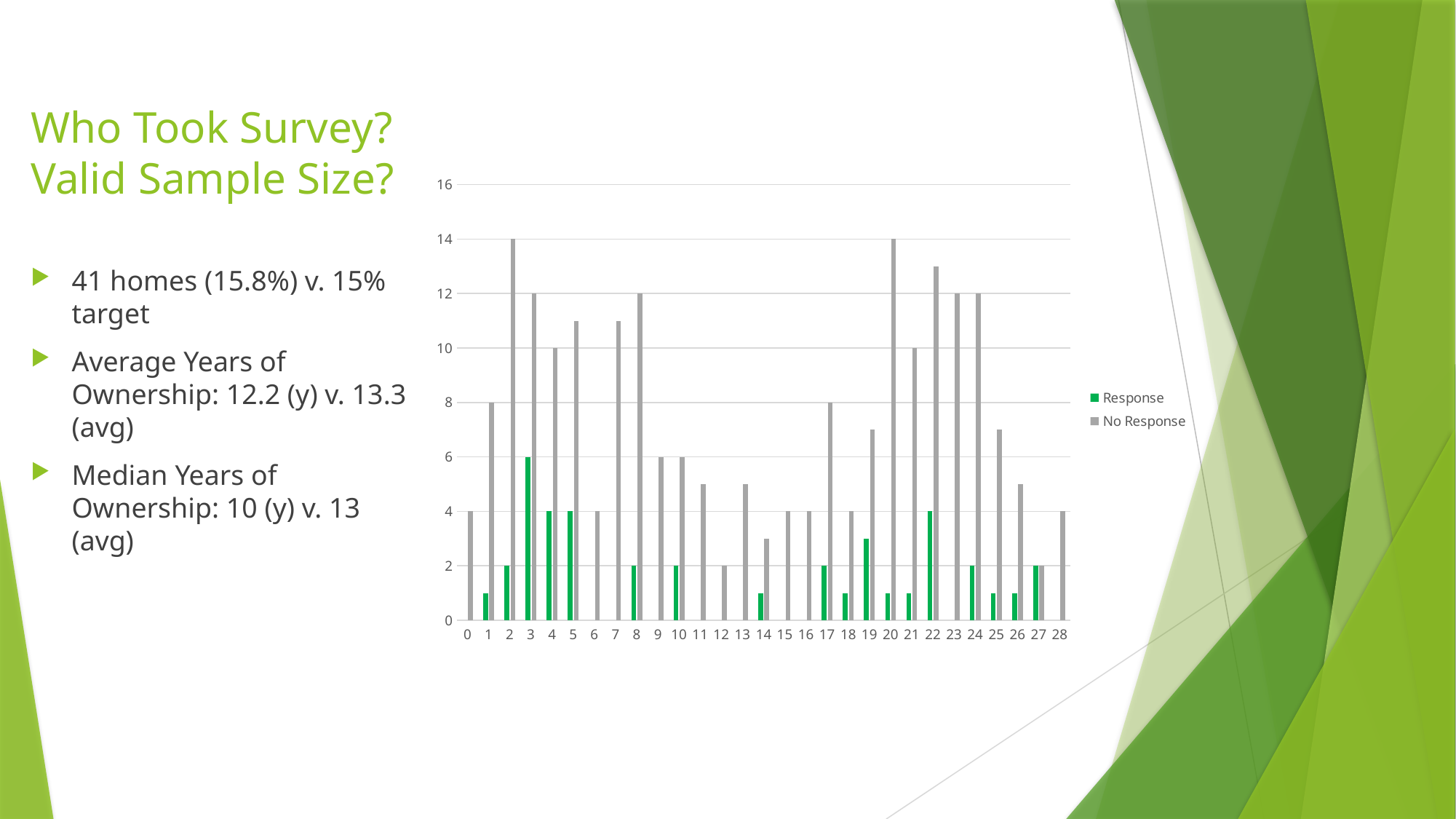
What kind of chart is shown on the slide? bar chart Is the No Response value for category 1 greater or less than 10? less How many categories are shown along the x axis of the chart? 29 What is the No Response value for category 2? 14 Which is larger, the No Response value for category 2 or for category 12? category 2 What is the No Response value for category 3? 12 How many series does the chart legend list? 2 What is the difference between the No Response and Response values for category 3? 6 What are the two series named in the chart legend? Response and No Response Which category has the highest Response value? 3 What is the Response value for category 3? 6 Is the No Response value for category 20 greater or less than 12? greater